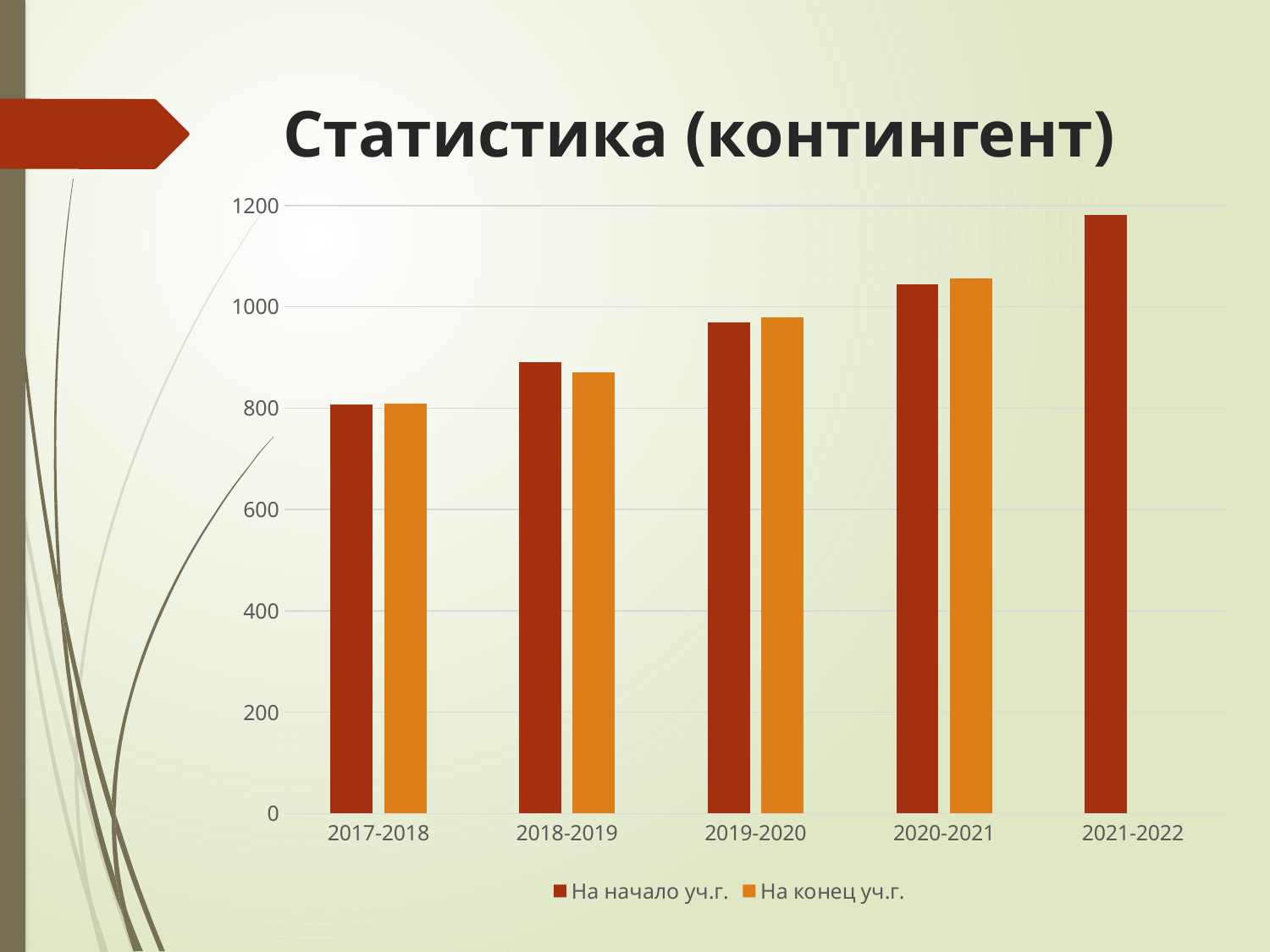
Which academic year has the highest value for "На начало уч.г."? 2021-2022 How many academic-year categories are shown on the x axis? 5 Which academic year has the lowest value for "На начало уч.г."? 2017-2018 What kind of chart is shown on the slide? bar chart Which is larger: the "На начало уч.г." value for 2021-2022 or for 2017-2018? 2021-2022 How many series does the legend list? 2 Is the value for "На конец уч.г." in 2020-2021 greater or less than 1000? greater Which academic year has the lowest value for "На конец уч.г."? 2017-2018 Do the "На начало уч.г." values rise or fall from 2017-2018 to 2021-2022? rise Is the value for "На начало уч.г." in 2018-2019 greater or less than 1000? less Is the value for "На начало уч.г." in 2021-2022 greater or less than 1000? greater What is the title of the chart? Статистика (контингент)